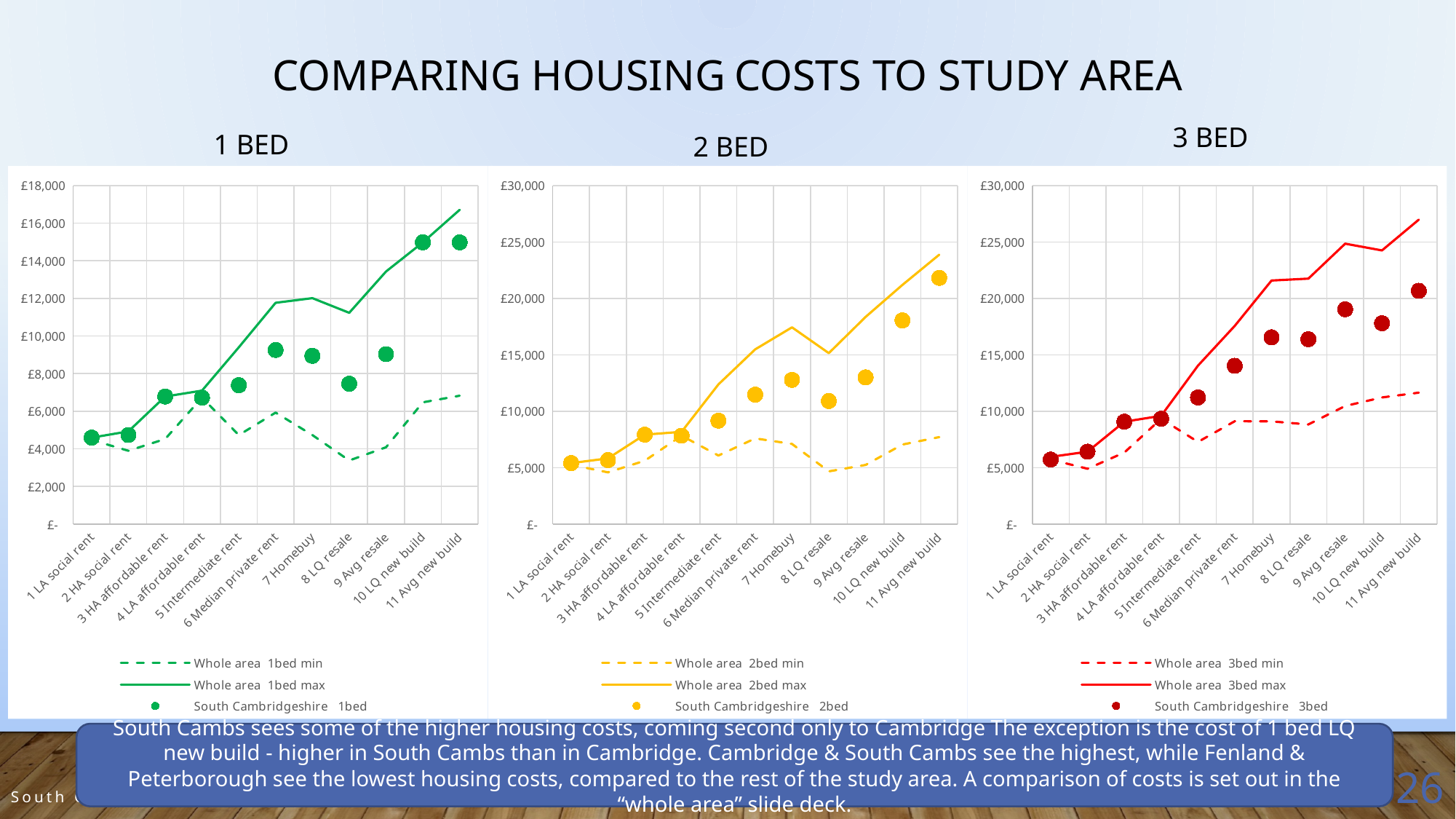
In the 1 BED chart, is the value for Whole area 1bed min at 1 LA social rent greater or less than £6,000? less In the 1 BED chart, is the value for South Cambridgeshire 1bed at 10 LQ new build greater or less than £14,000? greater What kind of chart is the 3 BED chart? Line chart In the 3 BED chart, do the Whole area 3bed max values generally rise or fall from 1 LA social rent to 11 Avg new build? rise In the 2 BED chart, which category has the highest value for South Cambridgeshire 2bed? 11 Avg new build In the 1 BED chart, which is larger for South Cambridgeshire 1bed: 6 Median private rent or 8 LQ resale? 6 Median private rent In the 3 BED chart, is the value for Whole area 3bed max at 11 Avg new build greater or less than £25,000? greater What is the highest value shown on the y axis of the 1 BED chart? £18,000 How many charts are on the slide? 3 In the 1 BED chart, how many categories are shown on the x axis? 11 In the 2 BED chart, how many series does the legend list? 3